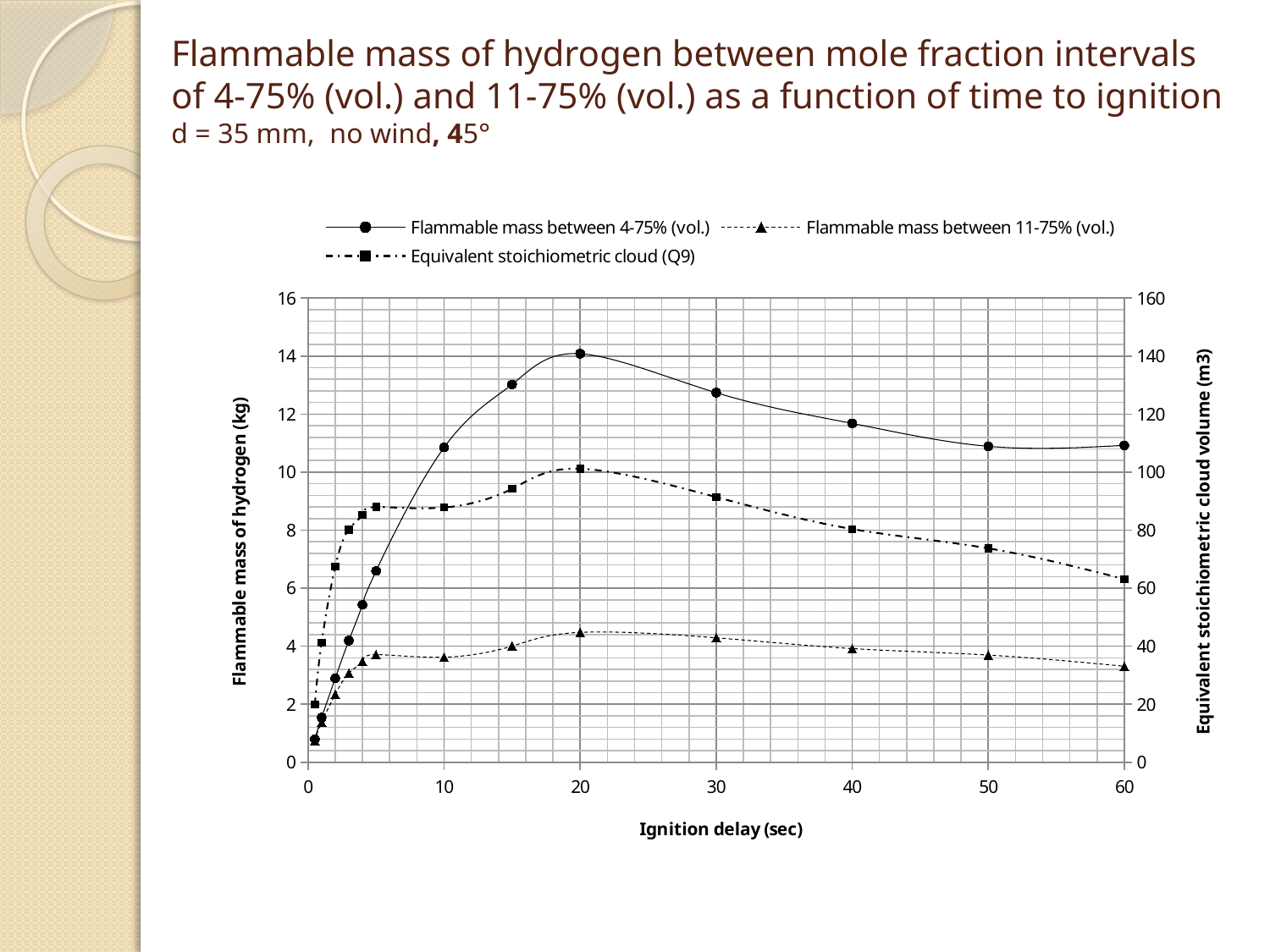
Is the value of 'Flammable mass between 4-75% (vol.)' at an ignition delay of 20 sec greater or less than 12? greater What is the title of the right-hand y axis? Equivalent stoichiometric cloud volume (m3) How many series does the legend list? 3 Between ignition delays of 0 sec and 20 sec, does the 'Flammable mass between 4-75% (vol.)' series rise or fall? rise Between ignition delays of 20 sec and 50 sec, does the 'Flammable mass between 4-75% (vol.)' series rise or fall? fall At an ignition delay of 30 sec, which series has the larger value: 'Flammable mass between 4-75% (vol.)' or 'Flammable mass between 11-75% (vol.)'? Flammable mass between 4-75% (vol.) What is the title of the x axis? Ignition delay (sec) Is the value of 'Equivalent stoichiometric cloud (Q9)' at an ignition delay of 30 sec greater or less than 80 on the right-hand axis? greater At which ignition delay does the 'Flammable mass between 4-75% (vol.)' series reach its highest value? 20 Is the value of 'Flammable mass between 11-75% (vol.)' at an ignition delay of 60 sec greater or less than 4? less What kind of chart is shown on the slide? line chart